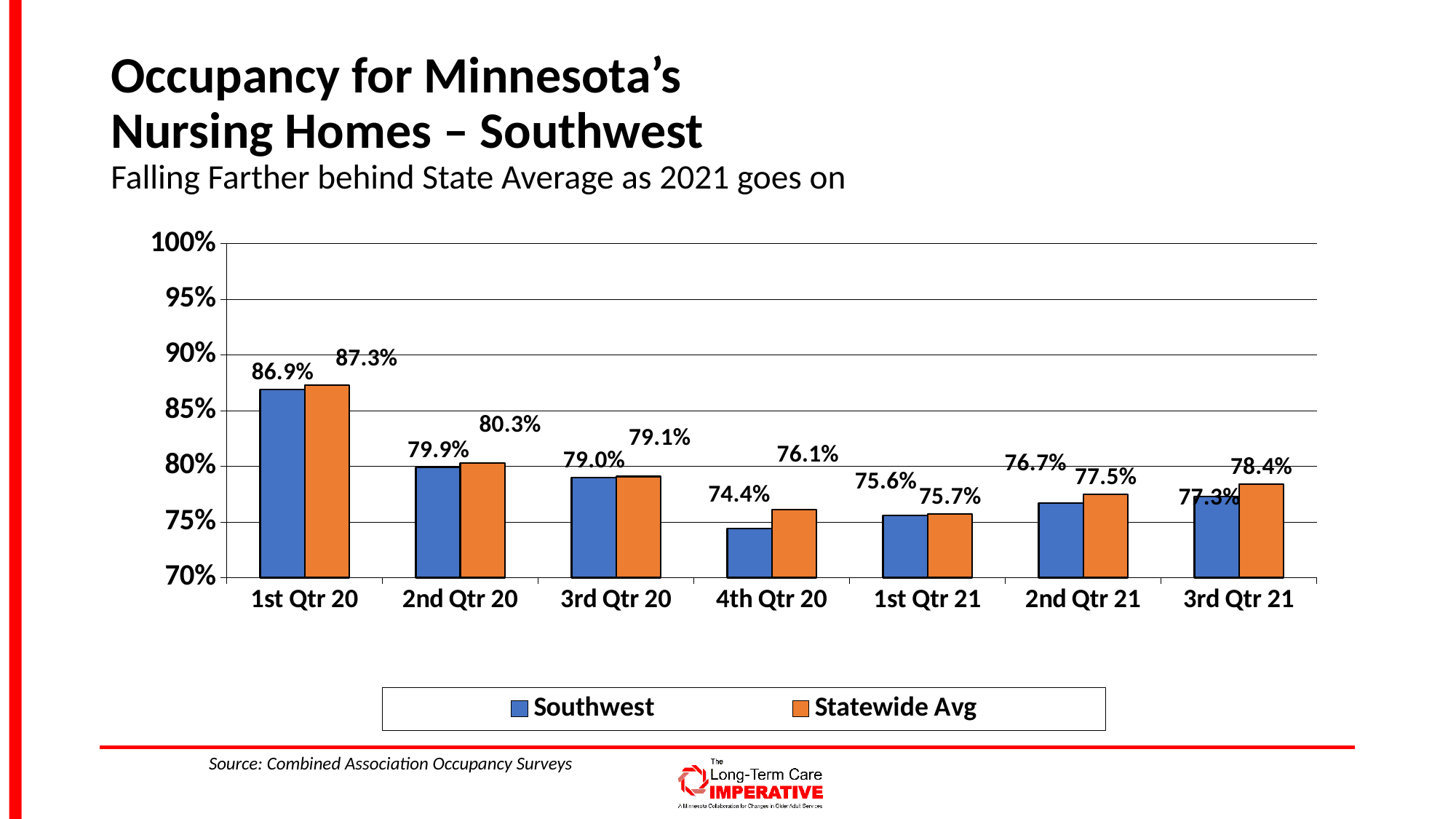
In which quarter is the Southwest occupancy lowest? 4th Qtr 20 What is the Statewide Avg occupancy value for 3rd Qtr 21? 78.4% Is the Southwest value for 4th Qtr 20 greater or less than 75%? less What is the Southwest occupancy value for 4th Qtr 20? 74.4% What is the Southwest occupancy value for 2nd Qtr 21? 76.7% In which quarter is the Southwest occupancy highest? 1st Qtr 20 What is the difference between the Statewide Avg and Southwest values in 3rd Qtr 21? 1.1 percentage points What is the difference between the Statewide Avg and Southwest values in 4th Qtr 20? 1.7 percentage points How many quarters are shown on the x axis? 7 In 4th Qtr 20, which is larger: the Southwest value or the Statewide Avg value? Statewide Avg How many series does the legend list? 2 What kind of chart is shown on the slide? Bar chart